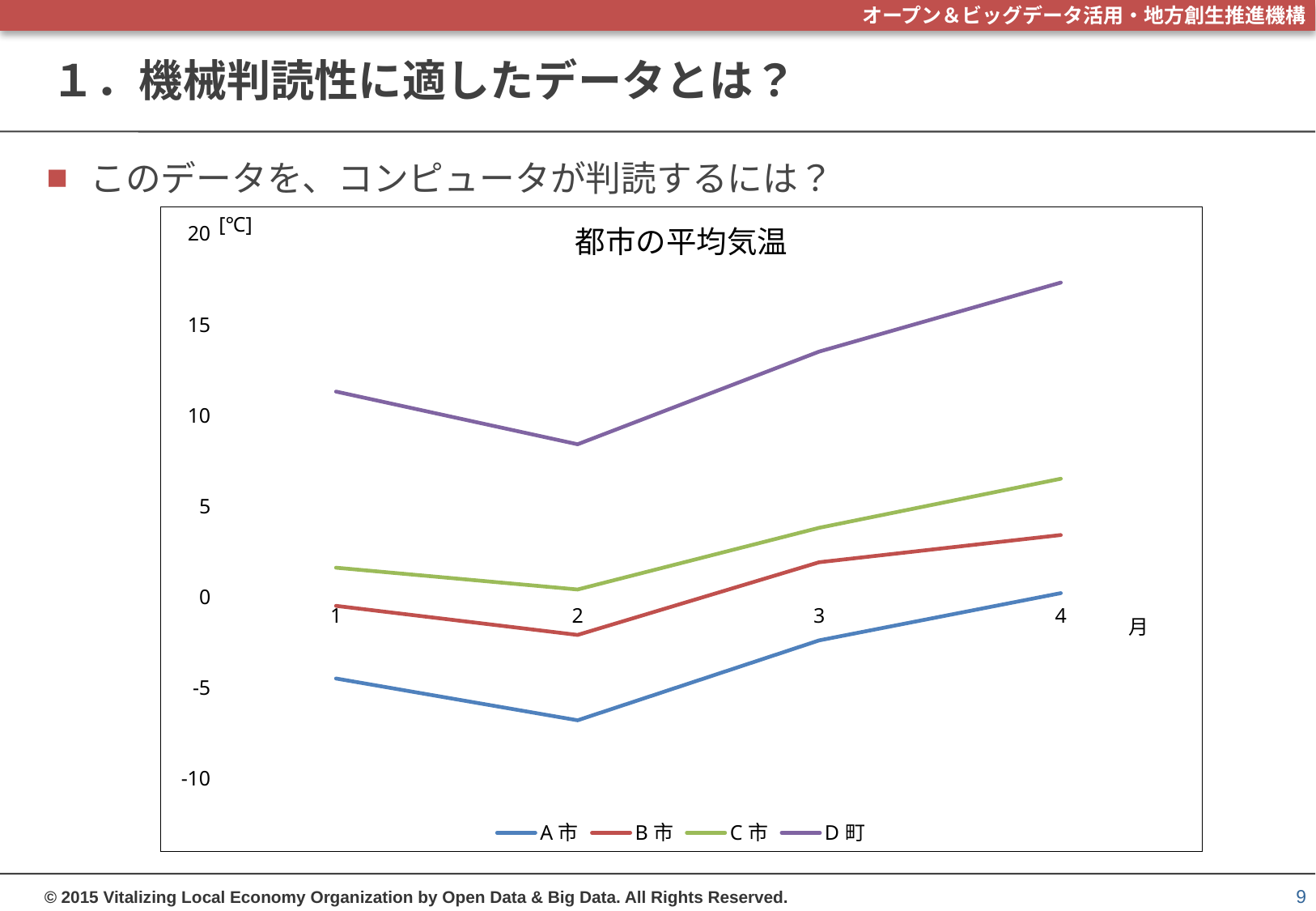
Which is larger in month 3, the value for A 市 or the value for B 市? B 市 What kind of chart is shown on the slide? line chart In which month does D 町 reach its highest value? 4 How many months are plotted along the x axis? 4 Does the value for C 市 rise or fall from month 2 to month 4? rise Is the value for D 町 in month 4 greater or less than 15? greater Is the value for A 市 in month 2 greater or less than -5? less What is the title of the chart? 都市の平均気温 Which series has the lowest value in month 2? A 市 How many series does the legend list? 4 Which series has the highest value in month 1? D 町 In which month does A 市 reach its lowest value? 2